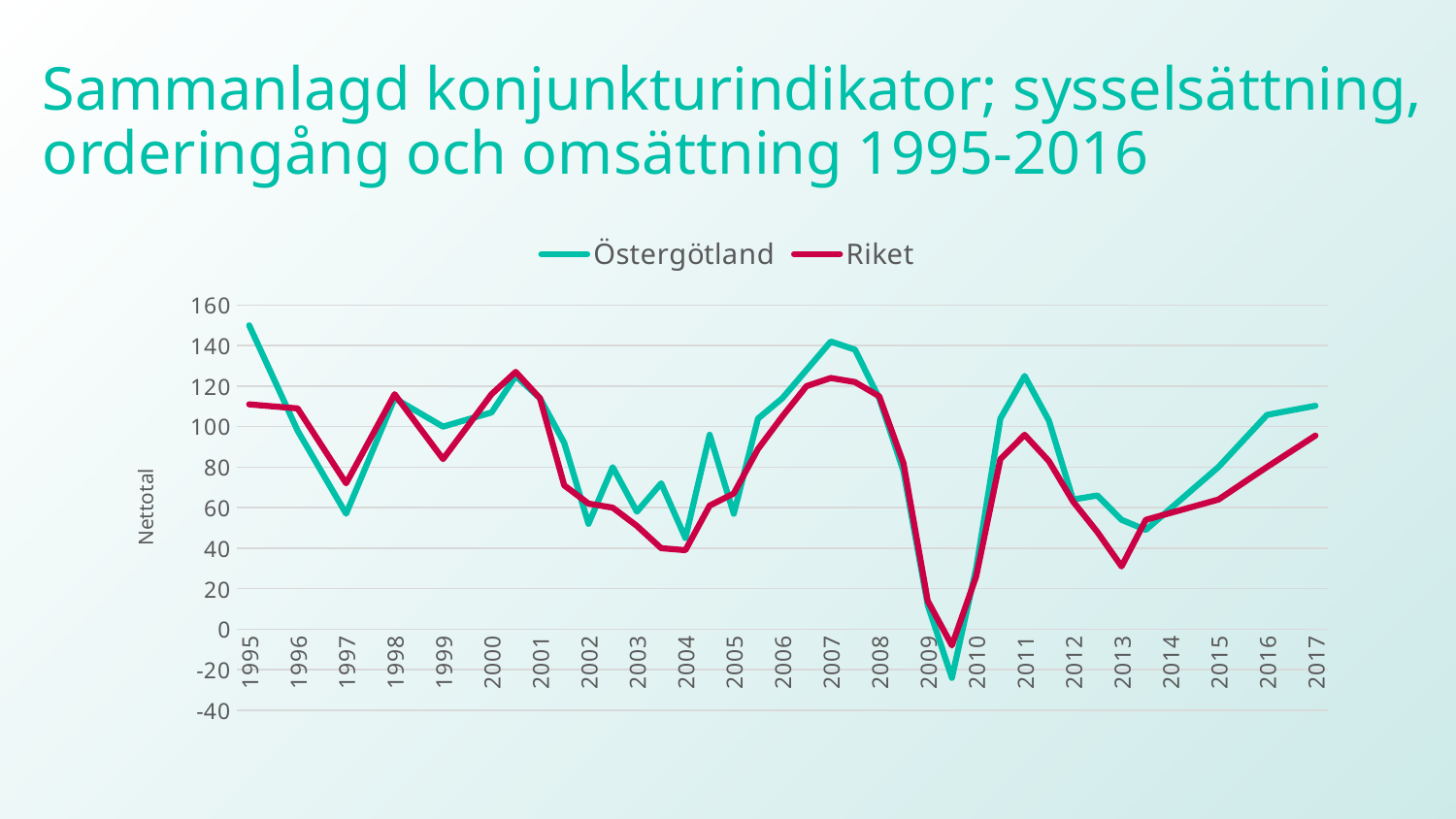
What are the two series named in the legend? Östergötland and Riket Is the value for Östergötland in 1995 greater or less than 140? greater In 1995, which series has the higher value, Östergötland or Riket? Östergötland Is the value for Östergötland in 2017 greater or less than 100? greater How many years are labelled on the x axis? 23 Does the Riket line rise or fall from 2013 to 2017? rise Is the value for Riket in 2017 greater or less than 100? less How many series does the legend list? 2 What is the label on the vertical axis? Nettotal What kind of chart is shown on the slide? line chart In 2011, which series has the higher value, Östergötland or Riket? Östergötland